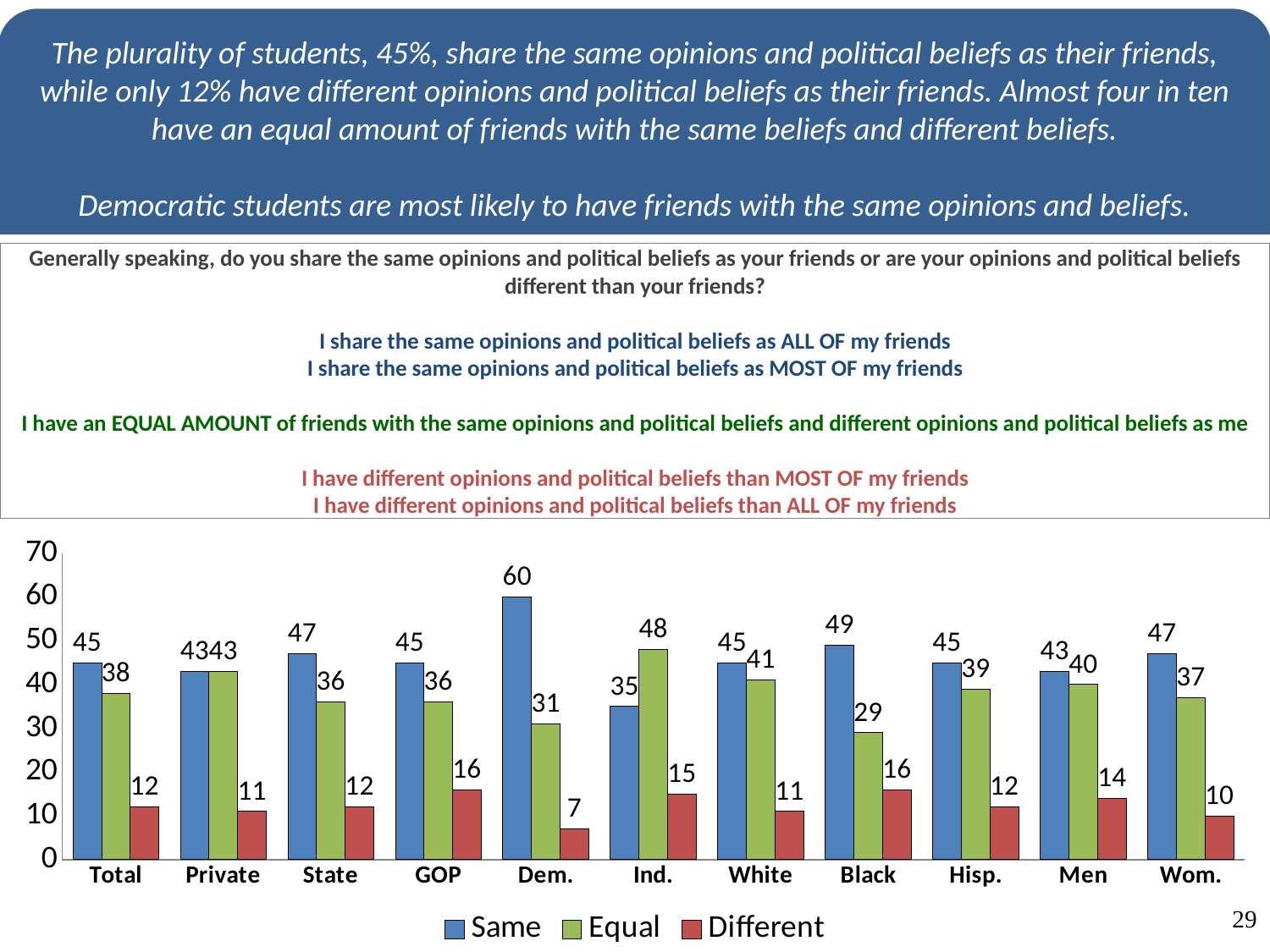
Which category has the lowest value for Different? Dem. Which is larger for Ind., Same or Equal? Equal What is the value for Different for Total? 12 What is the value for Equal for Black? 29 Which category has the highest value for Same? Dem. How many series does the legend list? 3 What is the value for Equal for Ind.? 48 How many categories are shown on the x axis? 11 What colour are the Different bars? red What is the value for Same for Dem.? 60 What kind of chart is shown? bar chart What is the difference between Same and Equal for Dem.? 29